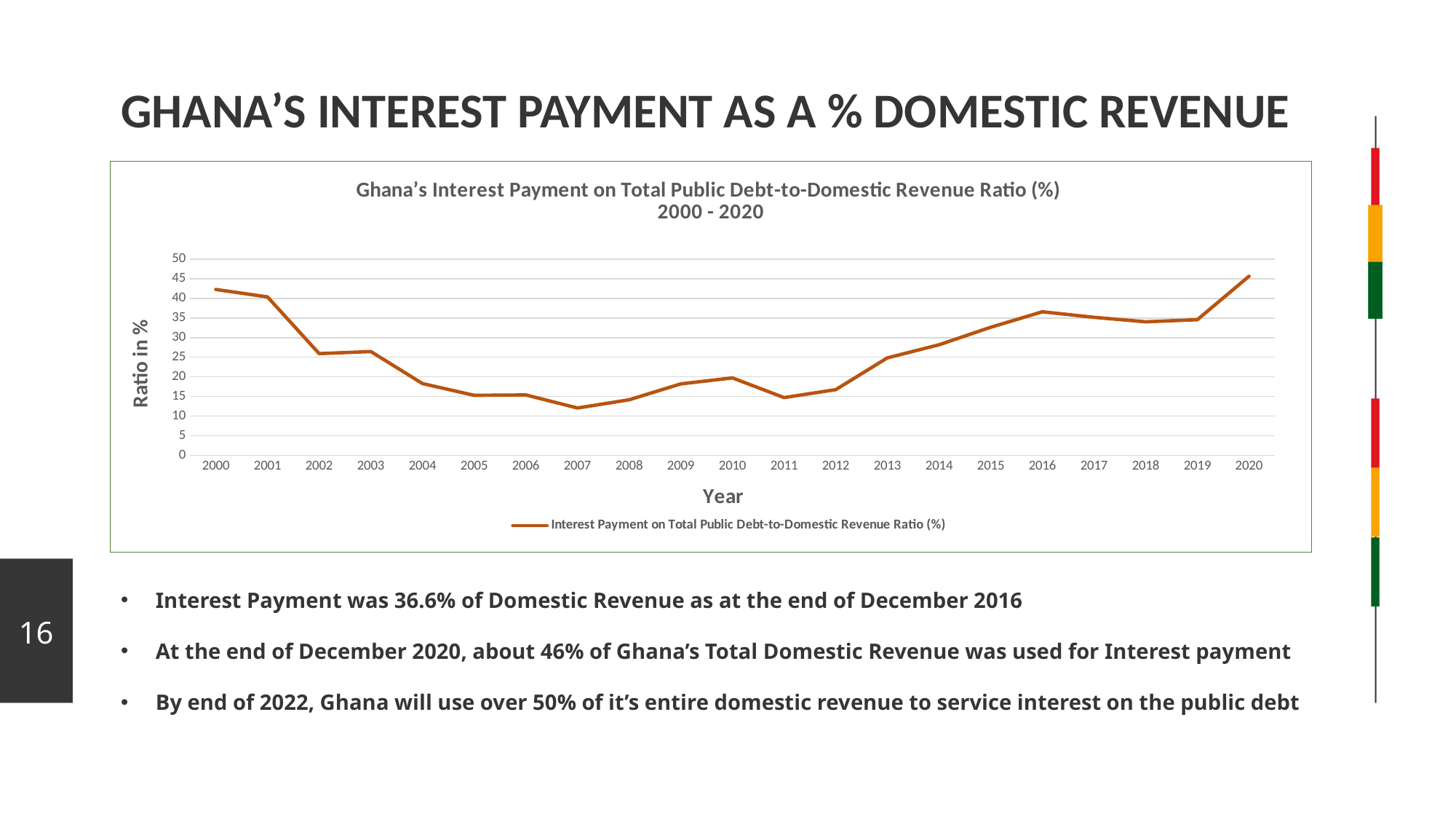
Which year has the lowest Interest Payment on Total Public Debt-to-Domestic Revenue Ratio? 2007 What kind of chart is shown on the slide? line chart Is the value for 2004 greater or less than 20? less Is the value for 2016 greater or less than 35? greater Does the ratio rise or fall from 2000 to 2007? fall Is the value for 2007 greater or less than 15? less How many years are plotted along the x axis? 21 What is the label on the y axis? Ratio in % Which is larger, the value for 2000 or the value for 2010? 2000 How many series does the legend list? 1 Which year has the highest Interest Payment on Total Public Debt-to-Domestic Revenue Ratio? 2020